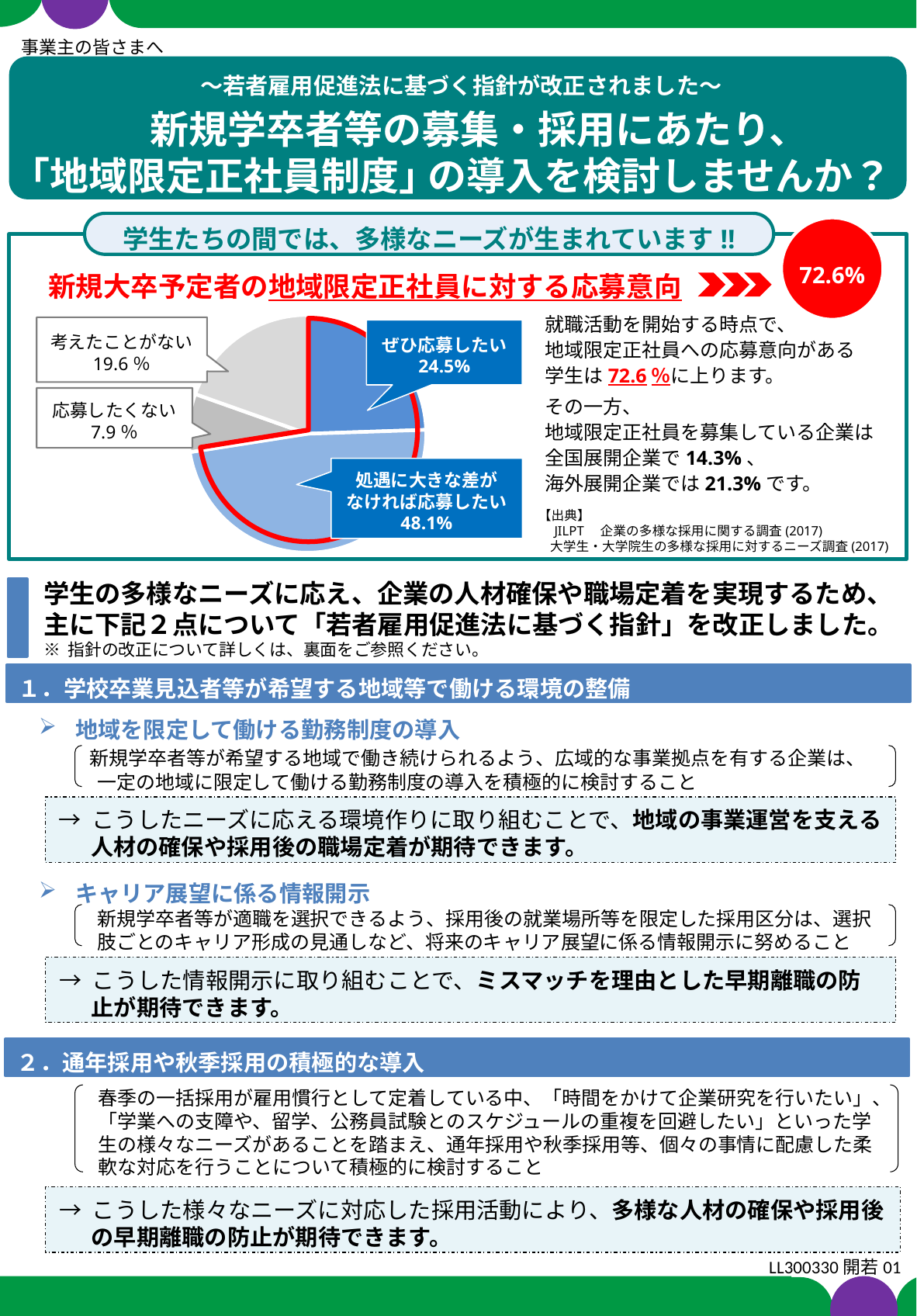
円グラフのタイトルは何ですか？ 新規大卒予定者の地域限定正社員に対する応募意向 このグラフはどの種類のグラフですか？ 円グラフ 円グラフで最も割合が大きい項目はどれですか？ 処遇に大きな差がなければ応募したい 「ぜひ応募したい」と「処遇に大きな差がなければ応募したい」の合計割合はいくつですか？ 72.6% 円グラフには項目がいくつありますか？ 4 円グラフで「応募したくない」の割合はいくつですか？ 7.9 % 円グラフで「処遇に大きな差がなければ応募したい」の割合はいくつですか？ 48.1% 「考えたことがない」と「応募したくない」では、どちらの割合が大きいですか？ 考えたことがない 円グラフで最も割合が小さい項目はどれですか？ 応募したくない 円グラフで「ぜひ応募したい」の割合はいくつですか？ 24.5% 「処遇に大きな差がなければ応募したい」と「ぜひ応募したい」の割合の差はいくつですか？ 23.6% 円グラフで「考えたことがない」の割合はいくつですか？ 19.6 %